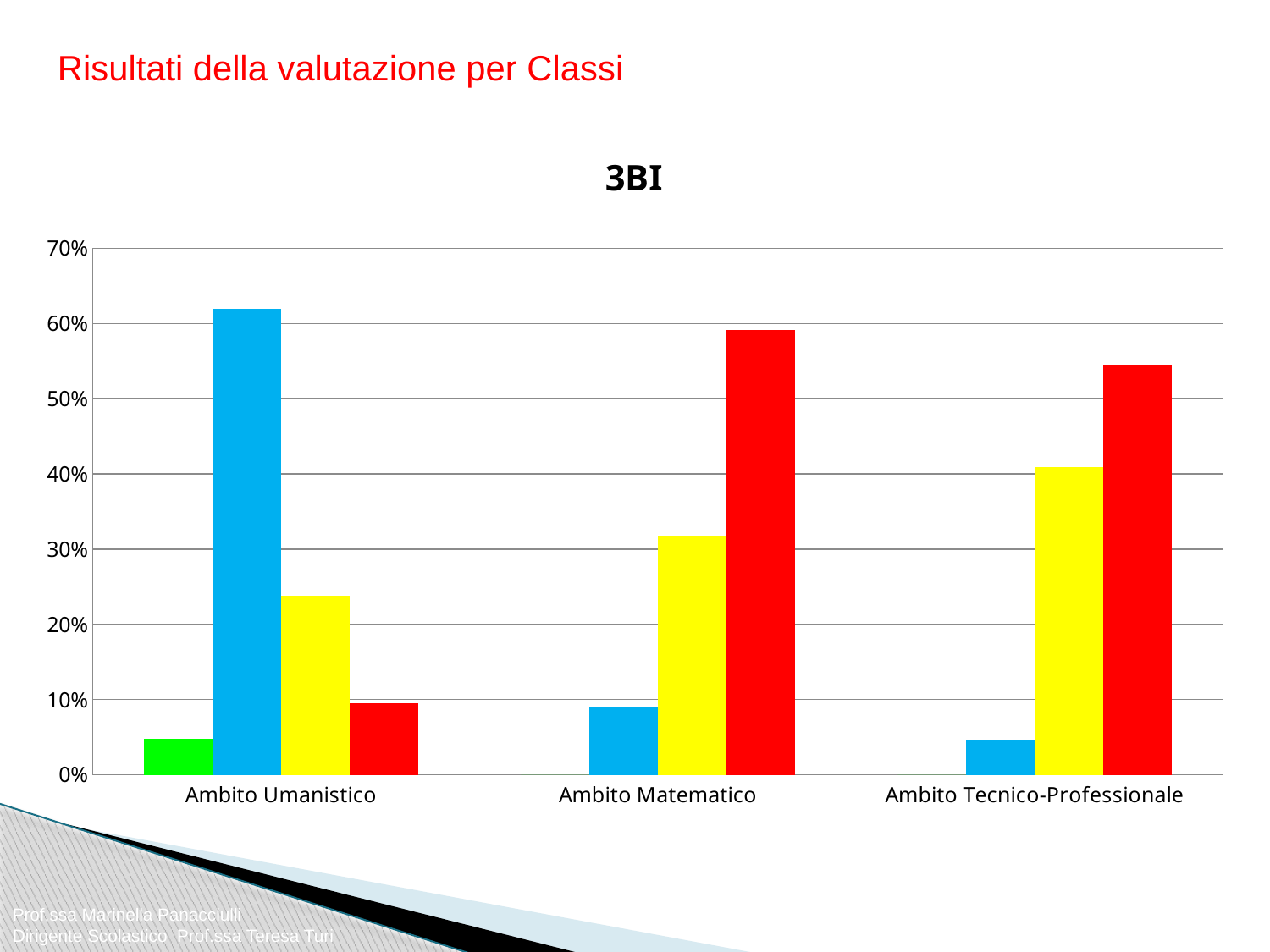
Which coloured bar is the shortest in the Ambito Umanistico group? green How many categories are shown on the x axis? 3 How many bars are plotted for Ambito Umanistico? 4 Is the value of the blue bar for Ambito Tecnico-Professionale greater or less than 10%? less Is the value of the yellow bar for Ambito Matematico greater or less than 30%? greater What kind of chart is shown on the slide? bar chart Is the value of the blue bar for Ambito Umanistico greater or less than 60%? greater Which coloured bar is the tallest in the Ambito Umanistico group? blue Which is larger: the red bar for Ambito Matematico or the red bar for Ambito Tecnico-Professionale? Ambito Matematico What is the title of the chart? 3BI Which coloured bar is the tallest in the Ambito Matematico group? red Which is larger: the yellow bar for Ambito Matematico or the yellow bar for Ambito Tecnico-Professionale? Ambito Tecnico-Professionale